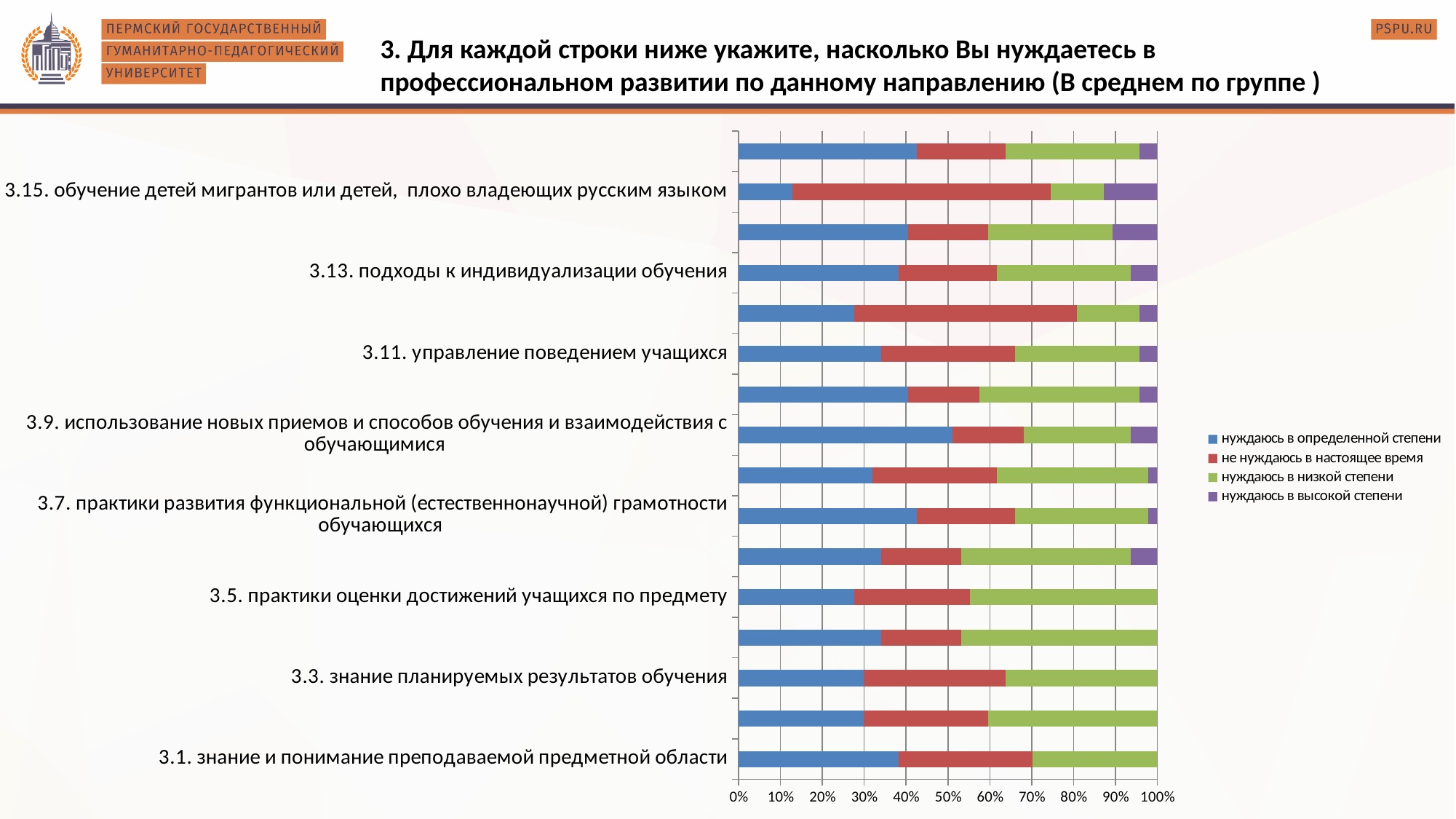
Which category has the largest blue segment (нуждаюсь в определенной степени)? 3.9. использование новых приемов и способов обучения и взаимодействия с обучающимися Which series is shown in blue according to the legend? нуждаюсь в определенной степени What kind of chart is shown on the slide? Stacked bar chart Which has the larger blue segment (нуждаюсь в определенной степени): 3.1 or 3.5? 3.1 Is the blue value (нуждаюсь в определенной степени) for 3.1 greater or less than 30%? greater Which has the larger blue segment (нуждаюсь в определенной степени): 3.9 or 3.15? 3.9 How many series does the legend list? 4 Which series is shown in purple according to the legend? нуждаюсь в высокой степени Is the red value (не нуждаюсь в настоящее время) for 3.15 greater or less than 50%? greater Is the blue value (нуждаюсь в определенной степени) for 3.15 greater or less than 20%? less Which category has the smallest blue segment (нуждаюсь в определенной степени)? 3.15. обучение детей мигрантов или детей, плохо владеющих русским языком How many bars are plotted in the chart? 16